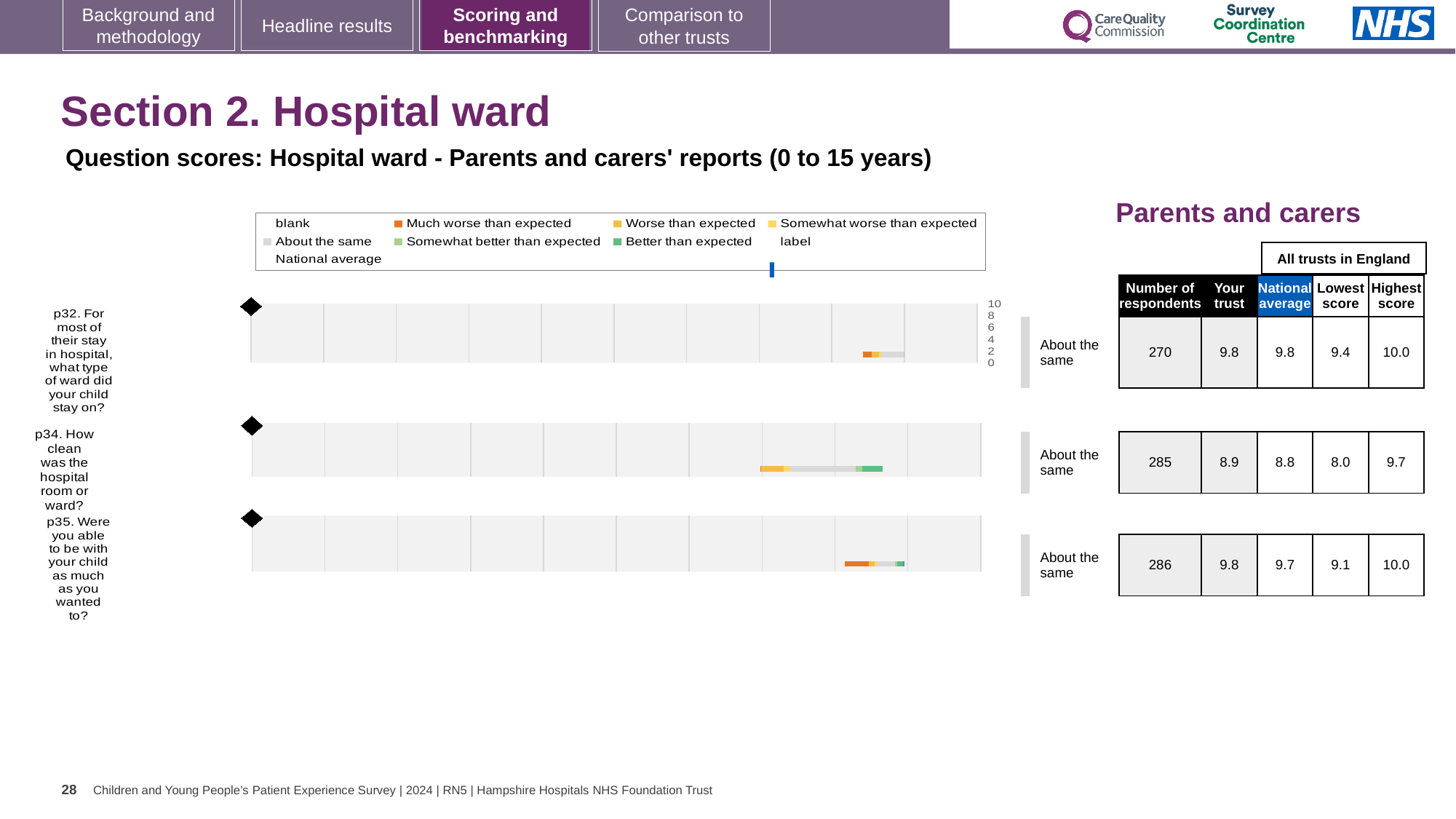
In the legend, what colour represents 'Better than expected'? green What is the lowest score across all trusts in England for p34? 8.0 What is the difference between the highest score and the lowest score for p34? 1.7 How many respondents answered p32 (For most of their stay in hospital, what type of ward did your child stay on?)? 270 What type of chart is used to show the question scores on this slide? bar chart What benchmark category is shown for p35? About the same How many questions (p32, p34, p35) are plotted on the slide? 3 Which question has the lowest 'Your trust' score? p34. How clean was the hospital room or ward? For p34, which is larger: the 'Your trust' score or the national average? Your trust What is the national average score for p35 (Were you able to be with your child as much as you wanted to?)? 9.7 Which question has the highest number of respondents? p35. Were you able to be with your child as much as you wanted to? What is the 'Your trust' score for p34 (How clean was the hospital room or ward?)? 8.9